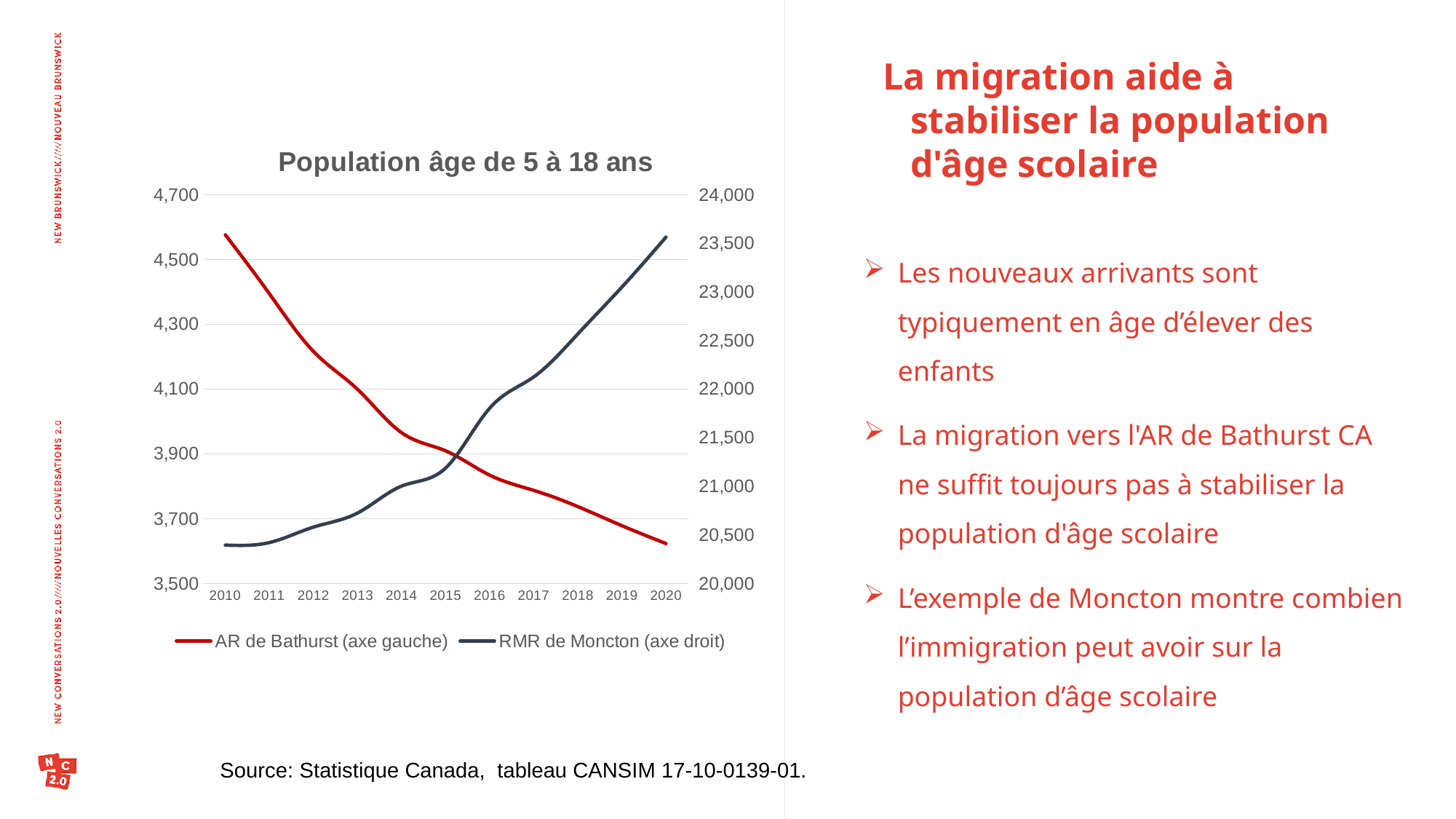
How many years are shown along the x axis of the chart? 11 What is the title of the chart? Population âge de 5 à 18 ans In which year is the AR de Bathurst value lowest? 2020 Is the value for AR de Bathurst in 2010 greater or less than 4,500? greater In which year is the RMR de Moncton value highest? 2020 Does the RMR de Moncton line rise or fall from 2010 to 2020? rise Does the AR de Bathurst line rise or fall from 2010 to 2020? fall In which year is the AR de Bathurst value highest? 2010 How many series does the chart legend list? 2 Is the value for RMR de Moncton in 2020 greater or less than 23,000? greater Is the value for AR de Bathurst in 2020 greater or less than 3,700? less What kind of chart is shown on the slide? line chart